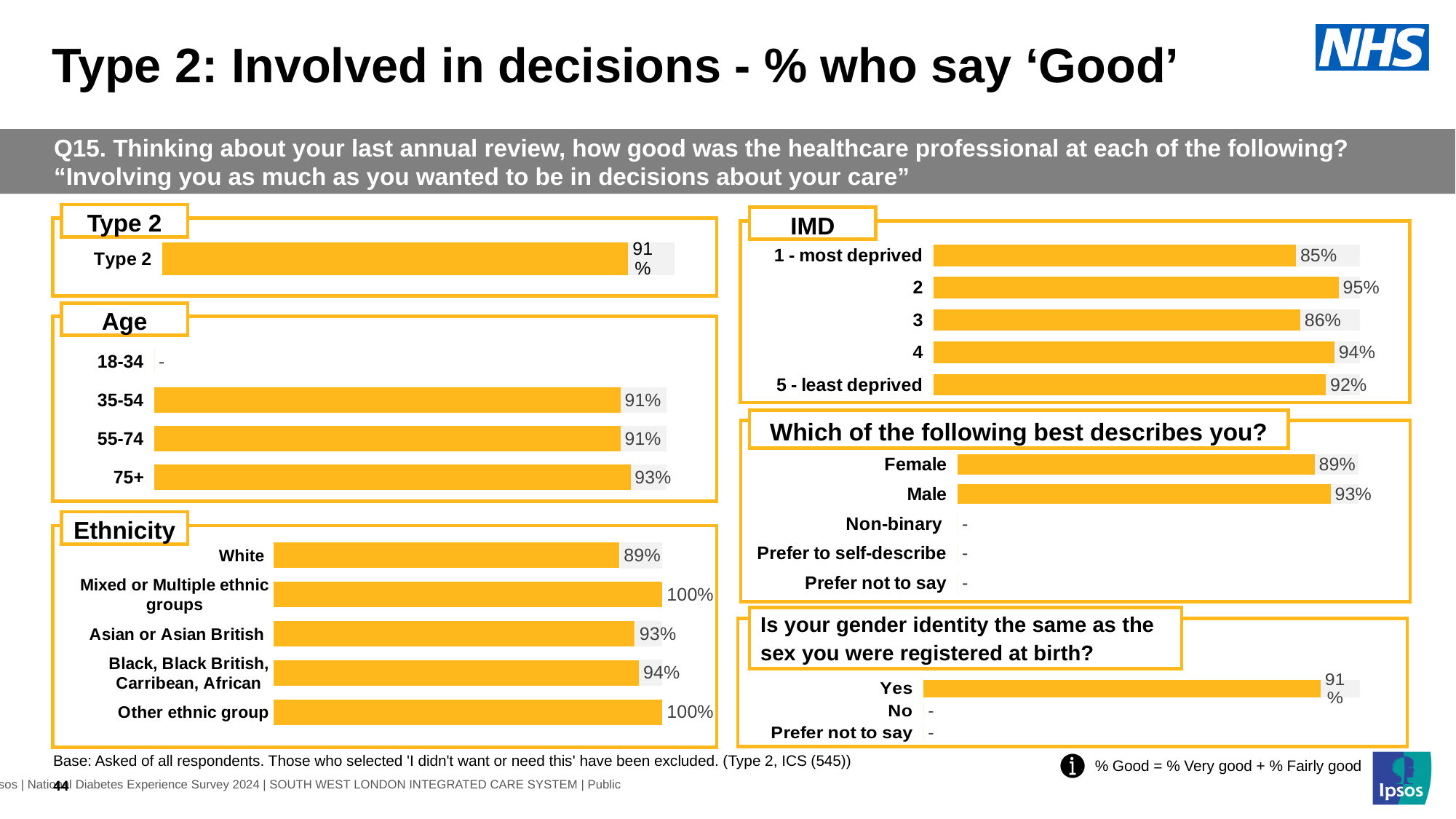
In the Ethnicity chart, what is the value for Asian or Asian British? 93% In the IMD chart, how many IMD categories are shown? 5 In the 'Is your gender identity the same as the sex you were registered at birth?' chart, what is the value for Yes? 91% In the Age chart, what is the value for 75+? 93% In the Type 2 chart, what is the value for Type 2? 91% In the IMD chart, what is the value for 1 - most deprived? 85% In the IMD chart, which IMD group has the highest value? 2 In the Ethnicity chart, which ethnic group has the lowest value? White In the Ethnicity chart, what is the difference between Black, Black British, Carribean, African and White? 5 percentage points In the Age chart, which age group has the highest value among those with a bar shown? 75+ In the IMD chart, which is larger, the value for 3 or the value for 4? 4 In the 'Which of the following best describes you?' chart, what is the difference between Male and Female? 4 percentage points